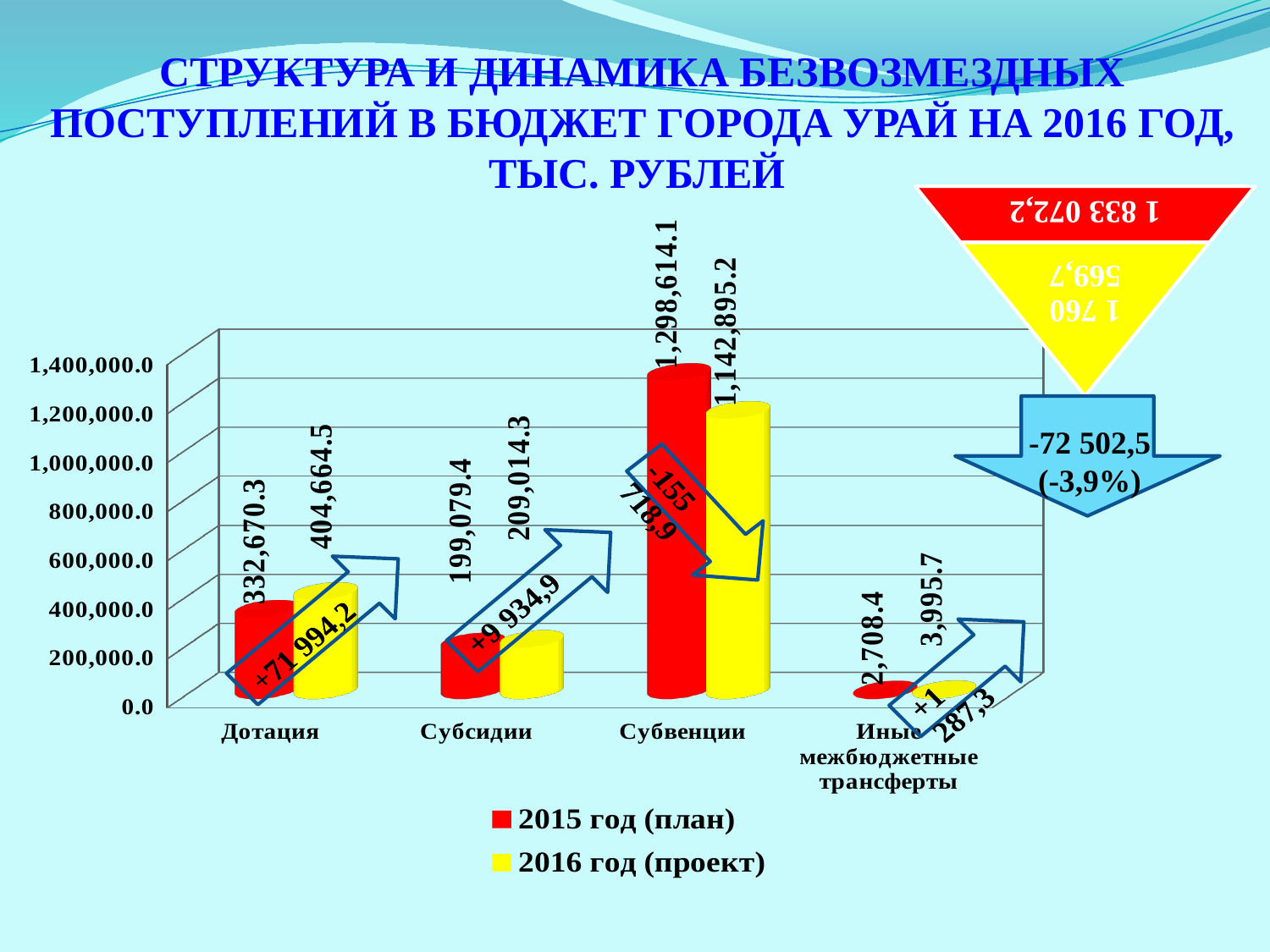
Which category has the highest 2016 год (проект) value? Субвенции What is the 2015 год (план) value for Иные межбюджетные трансферты? 2,708.4 How many categories are shown on the x axis of the chart? 4 What is the difference between the 2016 год (проект) and 2015 год (план) values for Дотация? 71,994.2 What is the 2016 год (проект) value for Дотация? 404,664.5 What is the 2016 год (проект) value for Субсидии? 209,014.3 What is the 2015 год (план) value for Субвенции? 1,298,614.1 For Субсидии, which is larger: the 2015 год (план) value or the 2016 год (проект) value? 2016 год (проект) What kind of chart is shown on the slide? Bar chart Which category has the lowest 2015 год (план) value? Иные межбюджетные трансферты How many series does the chart legend list? 2 What is the difference between the 2015 год (план) and 2016 год (проект) values for Субвенции? 155,718.9